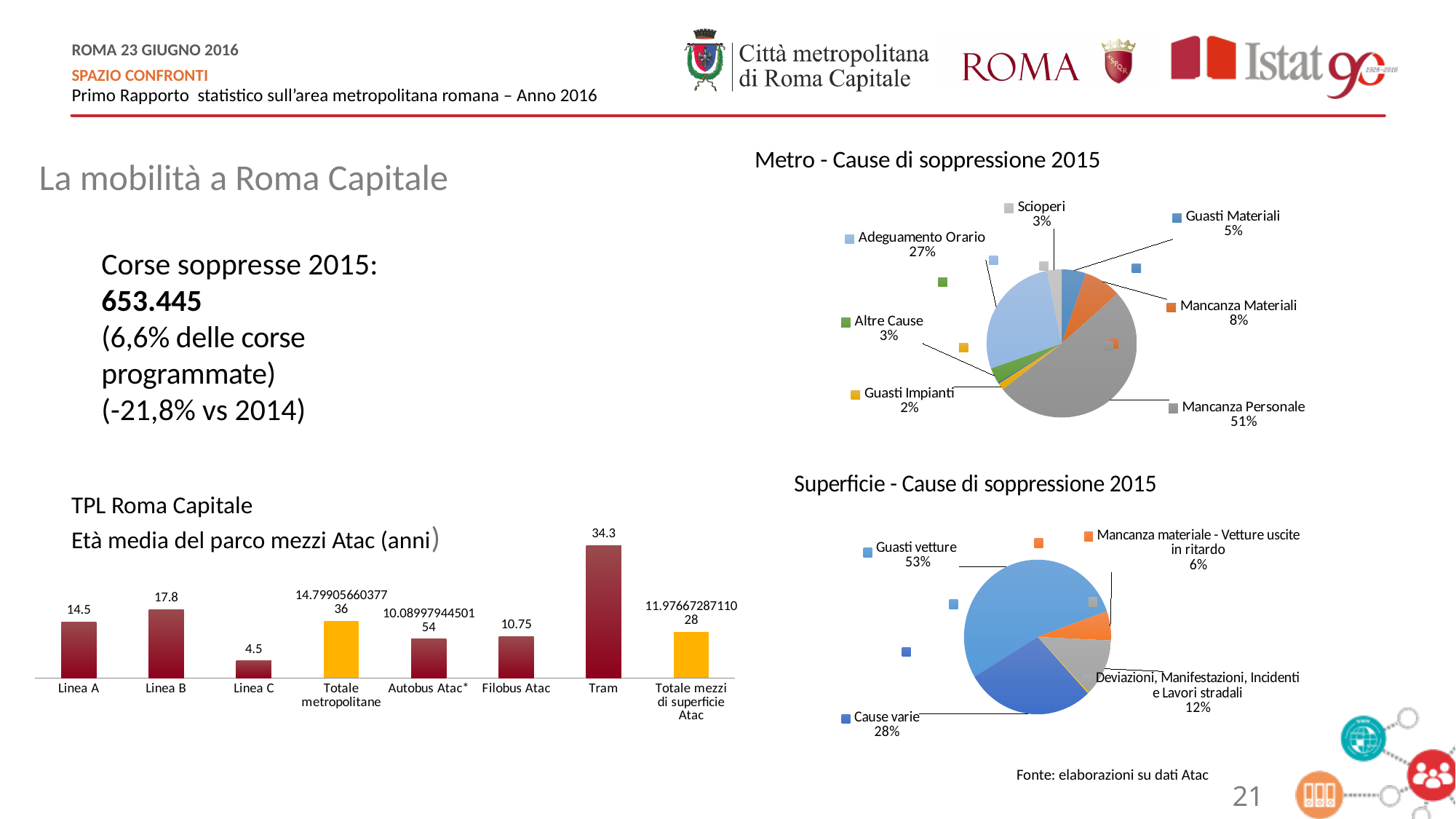
In the 'Superficie - Cause di soppressione 2015' chart, what share does Cause varie have? 28% How many categories are shown in the 'Età media del parco mezzi Atac (anni)' bar chart? 8 In the 'Età media del parco mezzi Atac (anni)' chart, which is larger, Filobus Atac or Linea A? Linea A In the 'Età media del parco mezzi Atac (anni)' chart, what is the value for Tram? 34.3 In the 'Età media del parco mezzi Atac (anni)' chart, which category has the highest value? Tram In the 'Superficie - Cause di soppressione 2015' chart, which cause has the largest share? Guasti vetture In the 'Età media del parco mezzi Atac (anni)' chart, what is the difference between Linea B and Linea A? 3.3 What type of chart is 'Metro - Cause di soppressione 2015'? Pie chart In the 'Età media del parco mezzi Atac (anni)' chart, what is the value for Linea C? 4.5 In the 'Età media del parco mezzi Atac (anni)' chart, which category has the lowest value? Linea C In the 'Metro - Cause di soppressione 2015' chart, what share does Mancanza Personale have? 51% In the 'Metro - Cause di soppressione 2015' chart, which cause has the smallest share? Guasti Impianti